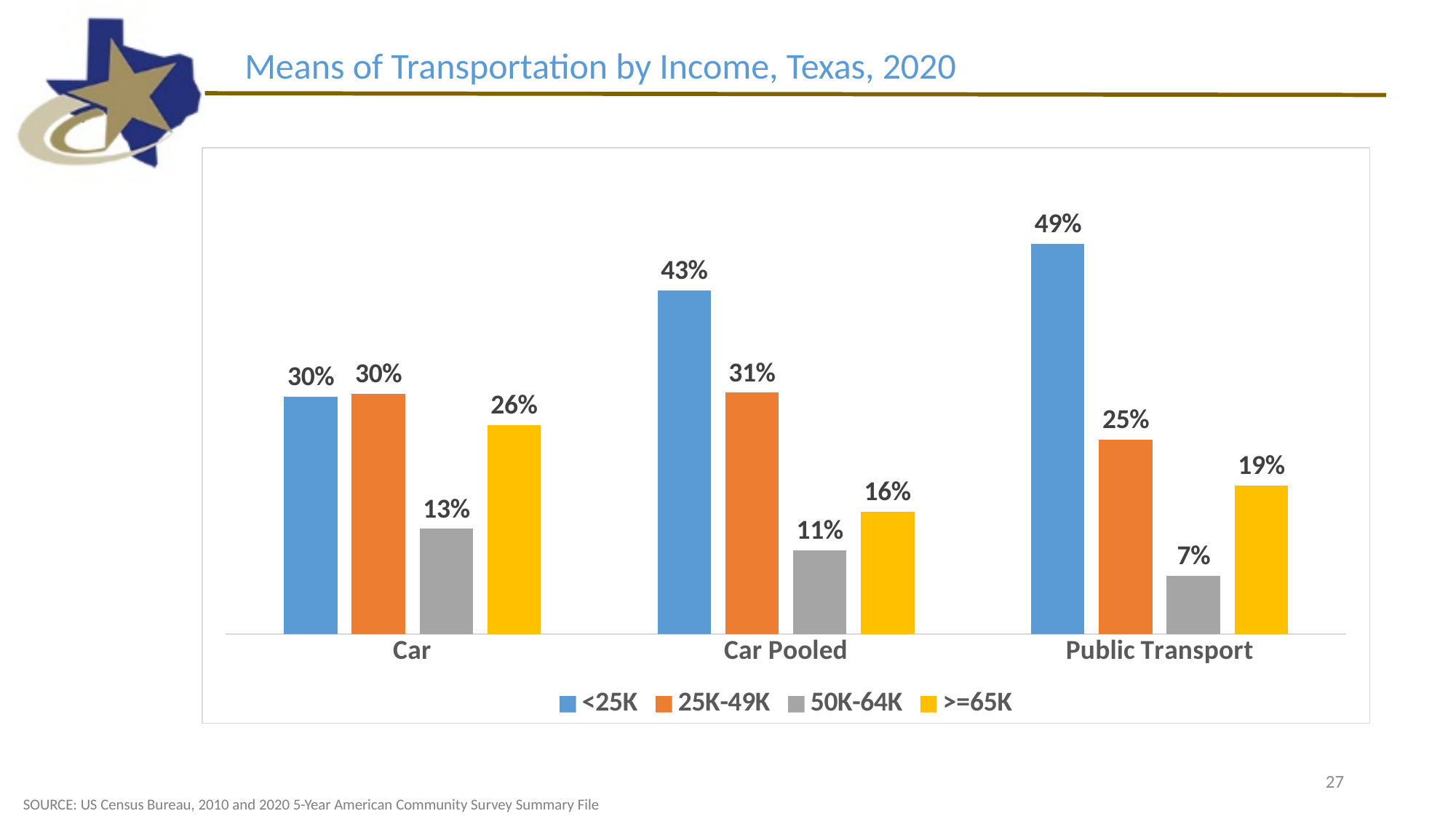
Which category has the highest value for the <25K series? Public Transport What is the value for the 50K-64K series in the Car category? 13% What is the difference between the <25K and >=65K values in the Car Pooled category? 27% Do the values for the 50K-64K series rise or fall from Car to Public Transport? Fall What kind of chart is shown on the slide? Bar chart How many categories are shown on the x axis? 3 What is the value for the <25K series in the Public Transport category? 49% Which category has the lowest value for the 50K-64K series? Public Transport How many series does the legend list? 4 What is the value for the >=65K series in the Car Pooled category? 16% What is the title of the chart? Means of Transportation by Income, Texas, 2020 Which is larger in the Public Transport category: the 25K-49K value or the >=65K value? 25K-49K